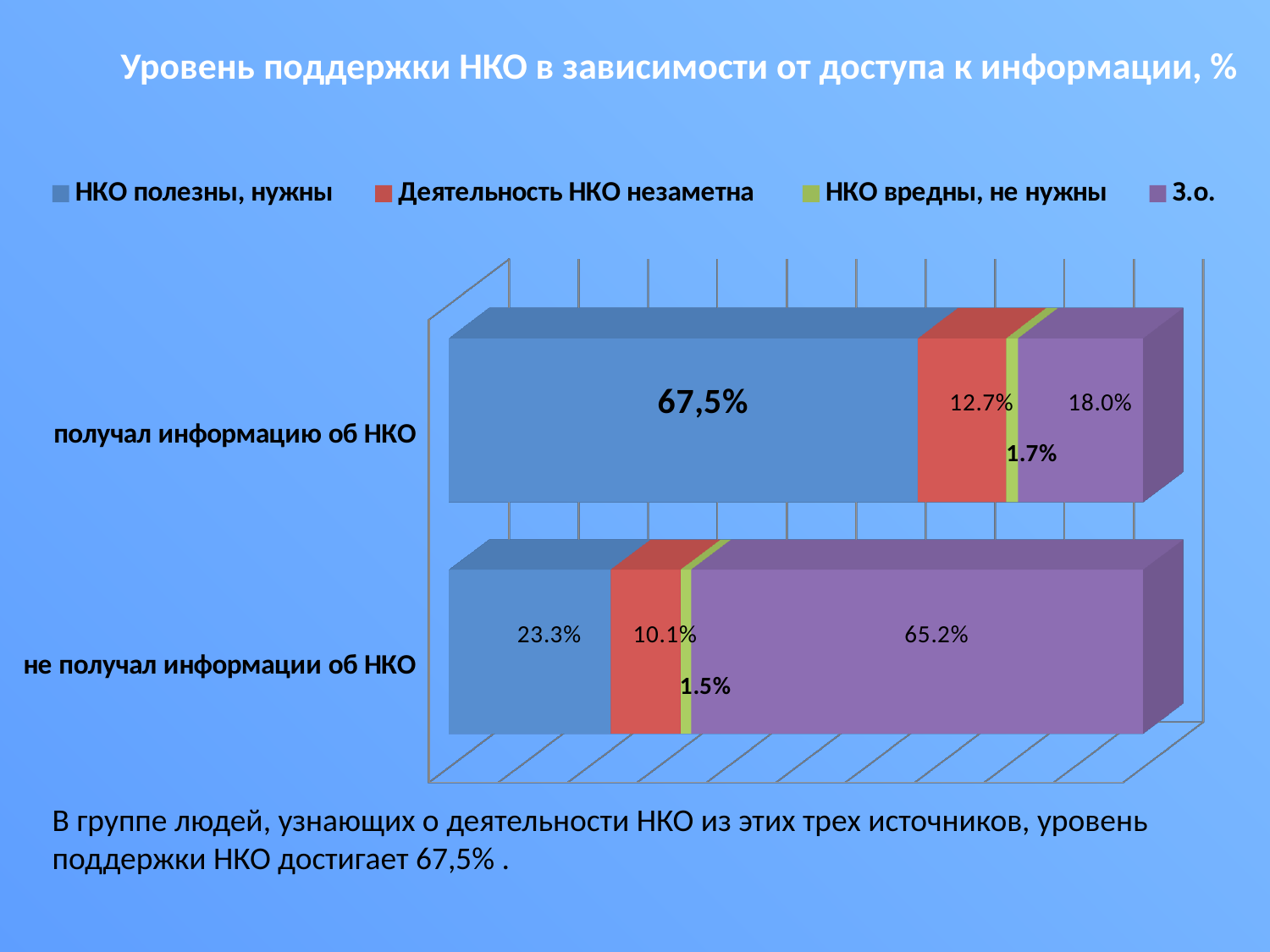
What value is shown for "НКО вредны, не нужны" in the "не получал информации об НКО" bar? 1.5% What value is shown for "НКО полезны, нужны" in the "не получал информации об НКО" bar? 23.3% What value is shown for "З.о." in the "не получал информации об НКО" bar? 65.2% What kind of chart is shown on the slide? Stacked bar chart What value is shown for "Деятельность НКО незаметна" in the "получал информацию об НКО" bar? 12.7% Which series has the largest value in the "не получал информации об НКО" bar? З.о. How many categories (bars) are shown in the chart? 2 Which series has the smallest value in the "получал информацию об НКО" bar? НКО вредны, не нужны What is the difference between the "З.о." values for "не получал информации об НКО" and "получал информацию об НКО"? 47.2% Which bar has the larger value for "Деятельность НКО незаметна": "получал информацию об НКО" or "не получал информации об НКО"? получал информацию об НКО How many series does the legend list? 4 What value is shown for "НКО полезны, нужны" in the "получал информацию об НКО" bar? 67,5%